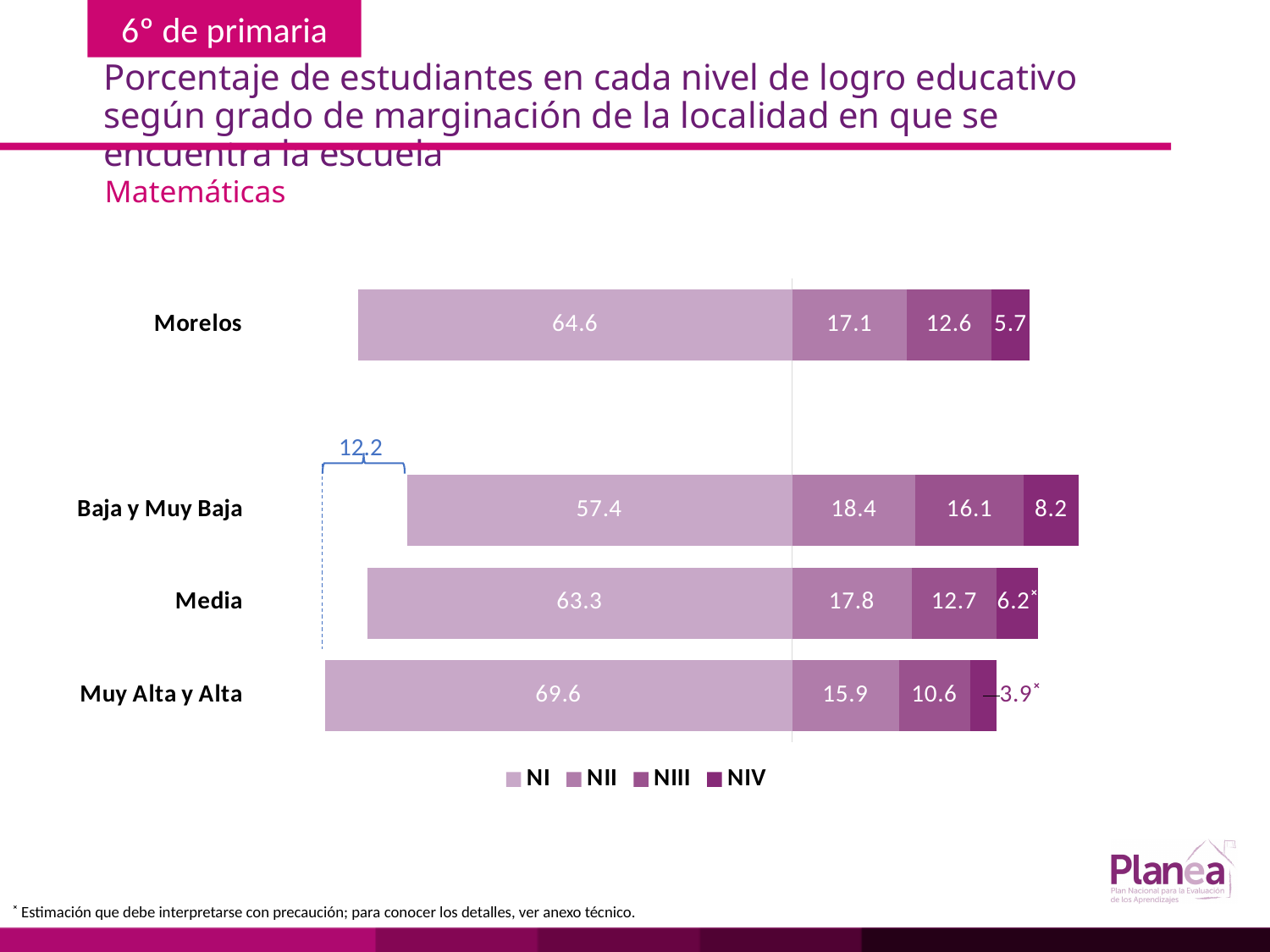
How many categories (bars) are shown in the chart? 4 What kind of chart is shown on the slide? stacked bar chart What is the NIV value for Muy Alta y Alta? 3.9 Which category has the lowest NIV value? Muy Alta y Alta What is the total of the stacked bar for Morelos? 100.0 What is the NIII value for Baja y Muy Baja? 16.1 What is the NI value for Morelos? 64.6 Which is larger, the NIV value for Baja y Muy Baja or the NIV value for Media? Baja y Muy Baja How many series does the legend list? 4 Which category has the highest NI value? Muy Alta y Alta What is the NII value for Media? 17.8 What is the difference between the NI values of Muy Alta y Alta and Baja y Muy Baja? 12.2